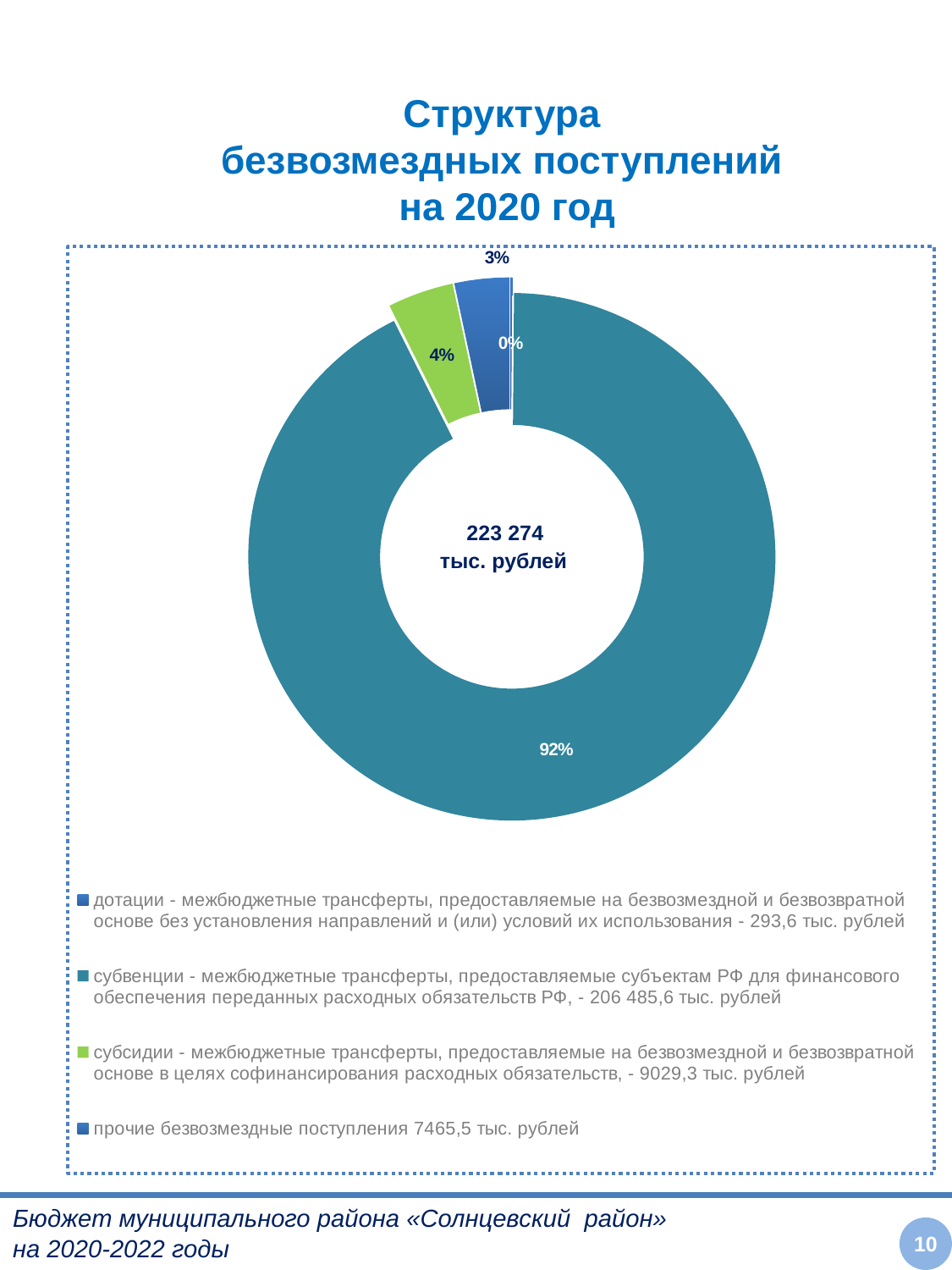
How many categories does the legend list? 4 Which has the larger share, субсидии or прочие безвозмездные поступления? субсидии What percentage share does дотации have in the chart? 0% According to the legend, what is the value for субсидии? 9029,3 тыс. рублей What percentage share does прочие безвозмездные поступления have in the chart? 3% What kind of chart is shown on the slide? Doughnut (pie) chart Which category has the smallest share of the chart? дотации What percentage share does субсидии have in the chart? 4% Which category has the largest share of the chart? субвенции According to the legend, what is the value for субвенции? 206 485,6 тыс. рублей What total value is shown in the centre of the doughnut chart? 223 274 тыс. рублей